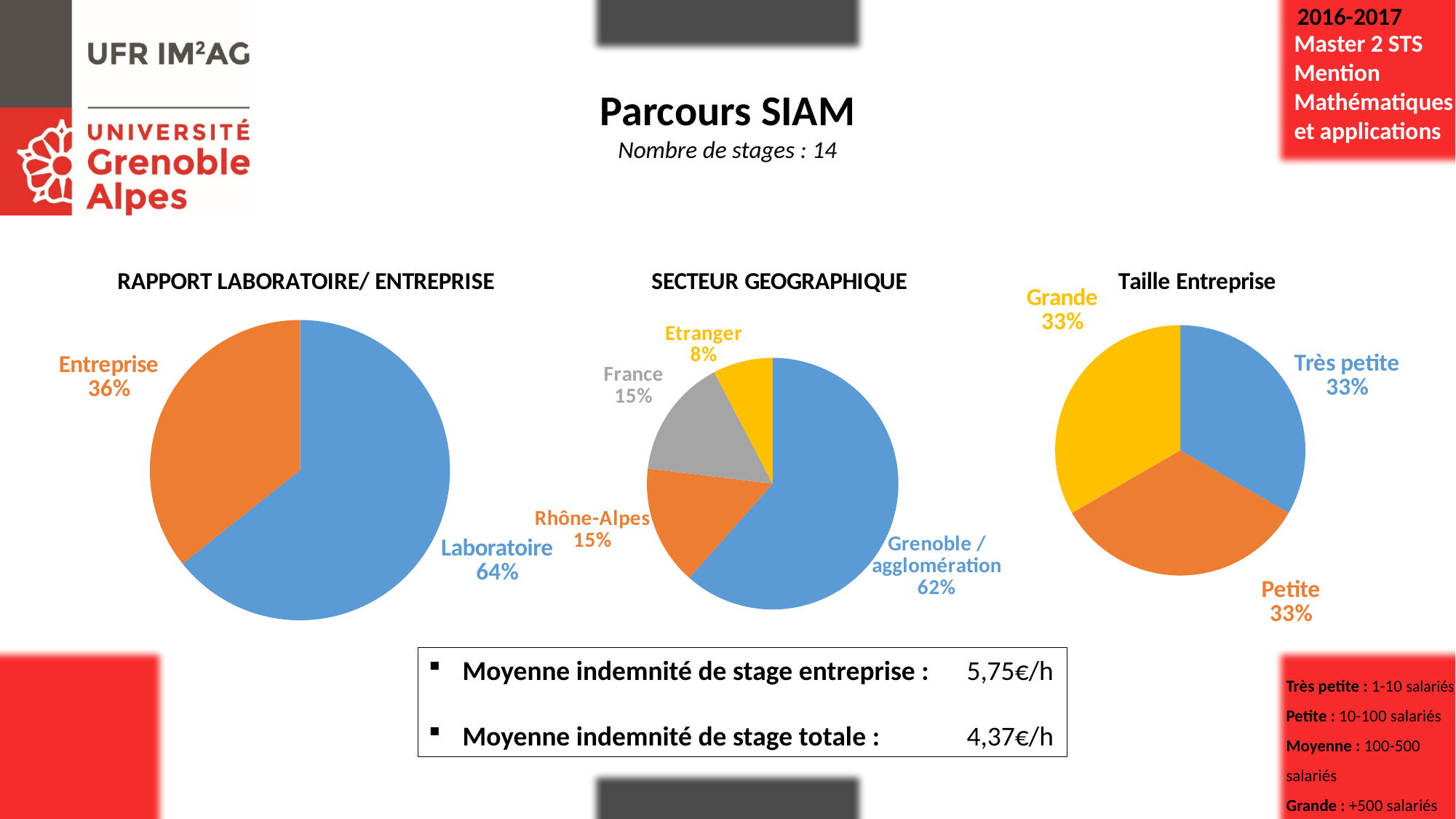
In the RAPPORT LABORATOIRE/ ENTREPRISE chart, what share is Laboratoire? 64% In the RAPPORT LABORATOIRE/ ENTREPRISE chart, what is the difference between the Laboratoire and Entreprise shares? 28% In the SECTEUR GEOGRAPHIQUE chart, which category has the largest share? Grenoble / agglomération In the SECTEUR GEOGRAPHIQUE chart, what share is Etranger? 8% In the SECTEUR GEOGRAPHIQUE chart, how many categories are shown? 4 In the Taille Entreprise chart, what share is Petite? 33% What kind of chart is the Taille Entreprise chart? Pie chart In the SECTEUR GEOGRAPHIQUE chart, which is larger, France or Etranger? France In the Taille Entreprise chart, how many categories are shown? 3 In the SECTEUR GEOGRAPHIQUE chart, which category has the smallest share? Etranger